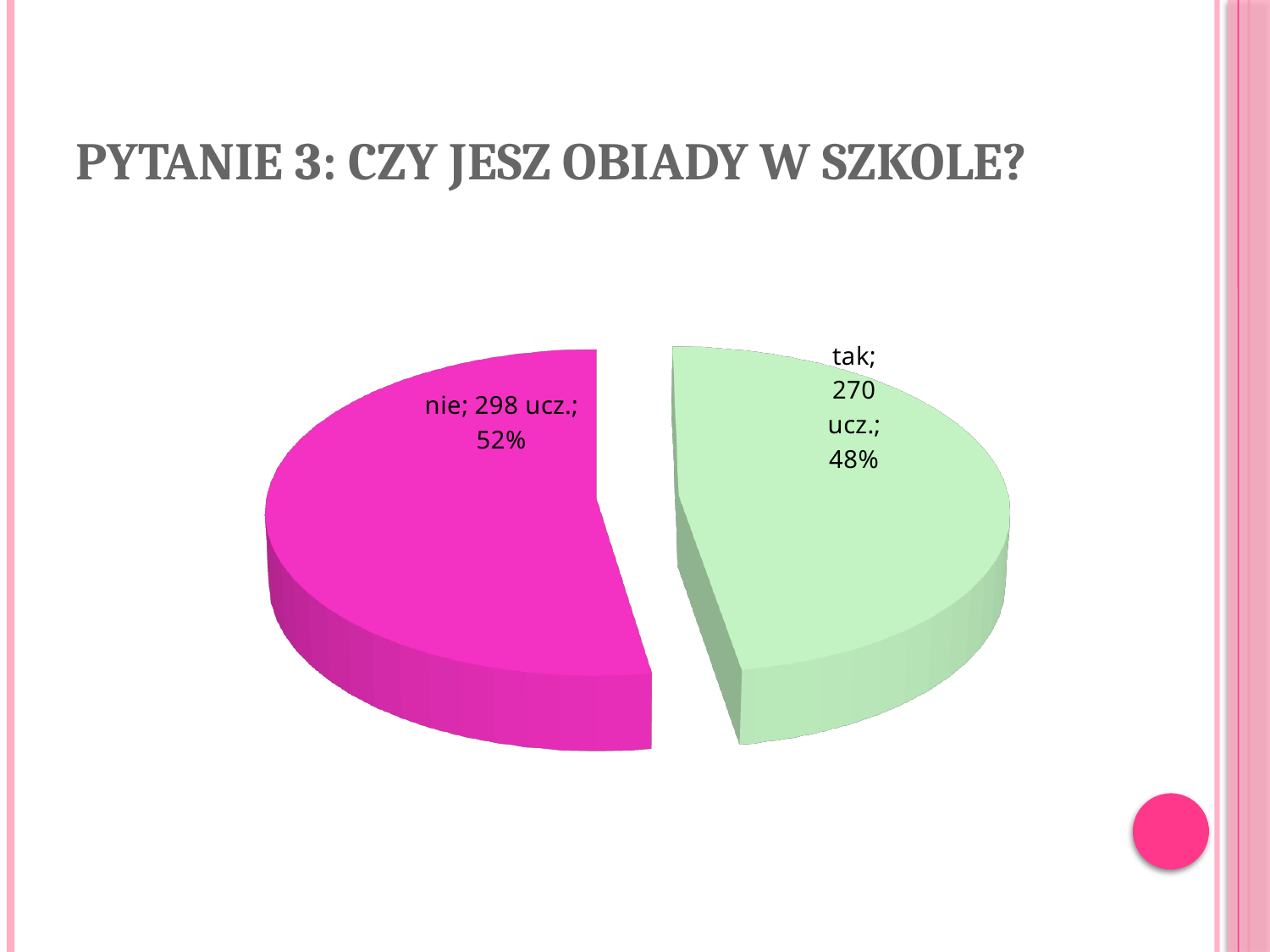
How many slices does the pie chart have? 2 What share of the pie does the "nie" slice represent? 52% Which answer has the larger slice, "tak" or "nie"? nie Which category has the smallest slice? tak How many students answered "tak"? 270 ucz. What is the title of the slide containing the chart? PYTANIE 3: CZY JESZ OBIADY W SZKOLE? What colour is the "tak" slice? light green What share of the pie does the "tak" slice represent? 48% What kind of chart is shown on the slide? pie chart What is the difference in number of students between "nie" and "tak"? 28 ucz. How many students answered "nie"? 298 ucz. What is the total number of students across both slices? 568 ucz.